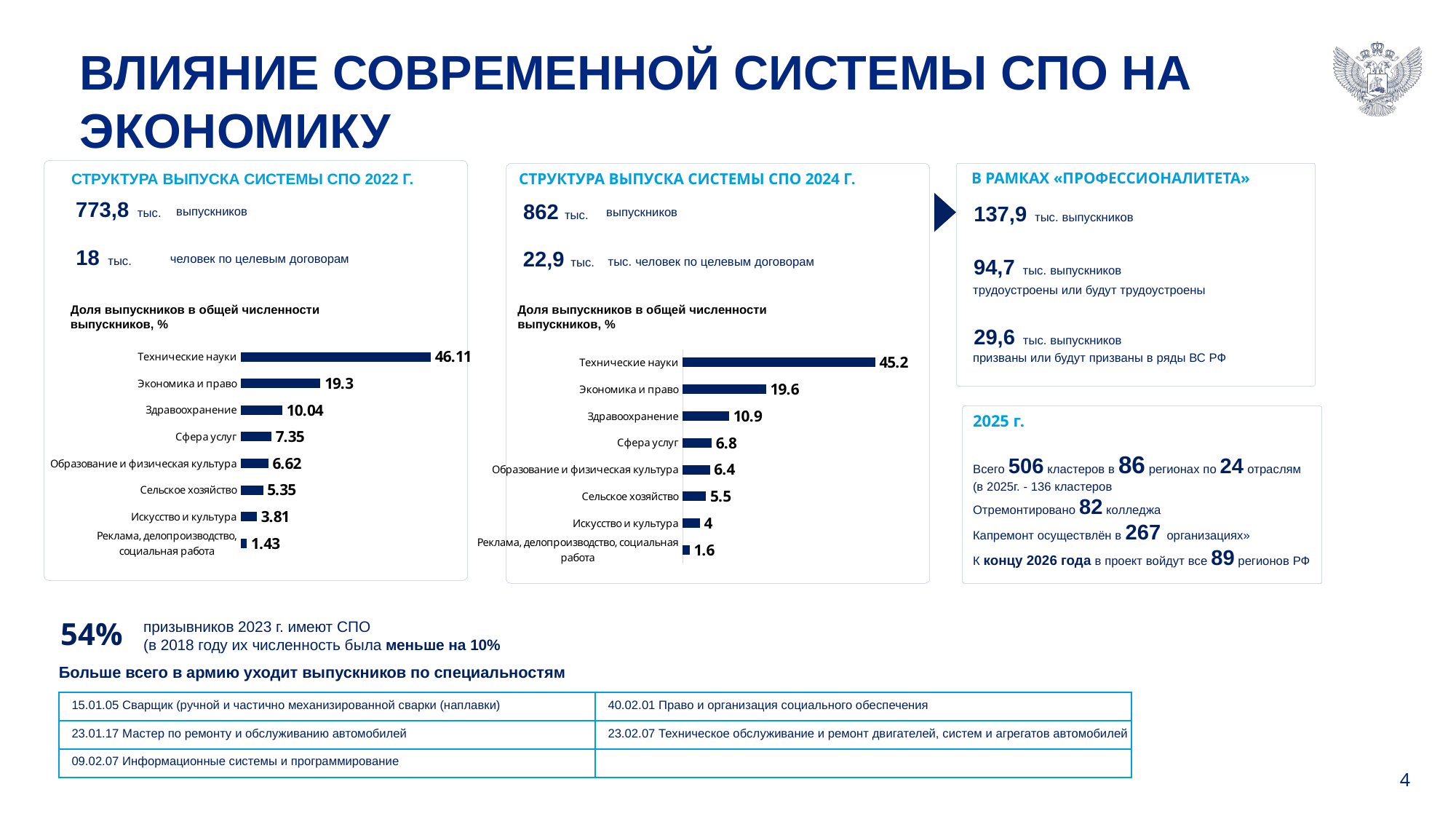
In the 2024 chart, which is larger: Сфера услуг or Образование и физическая культура? Сфера услуг What kind of chart is the 2024 chart (СТРУКТУРА ВЫПУСКА СИСТЕМЫ СПО 2024 Г.)? Bar chart In the 2022 chart, which category has the highest value? Технические науки In the 2024 chart, which category has the lowest value? Реклама, делопроизводство, социальная работа In the 2024 chart, what is the difference between Экономика и право and Здравоохранение? 8.7 In the 2024 chart (СТРУКТУРА ВЫПУСКА СИСТЕМЫ СПО 2024 Г.), what is the value for Здравоохранение? 10.9 In the 2022 chart, what is the value for Реклама, делопроизводство, социальная работа? 1.43 In the 2022 chart, what is the value for Сельское хозяйство? 5.35 In the 2022 chart (СТРУКТУРА ВЫПУСКА СИСТЕМЫ СПО 2022 Г.), what is the value for Технические науки? 46.11 In the 2024 chart, what is the value for Искусство и культура? 4 In the 2022 chart, what is the difference between Технические науки and Экономика и право? 26.81 How many categories are shown in the 2022 chart? 8